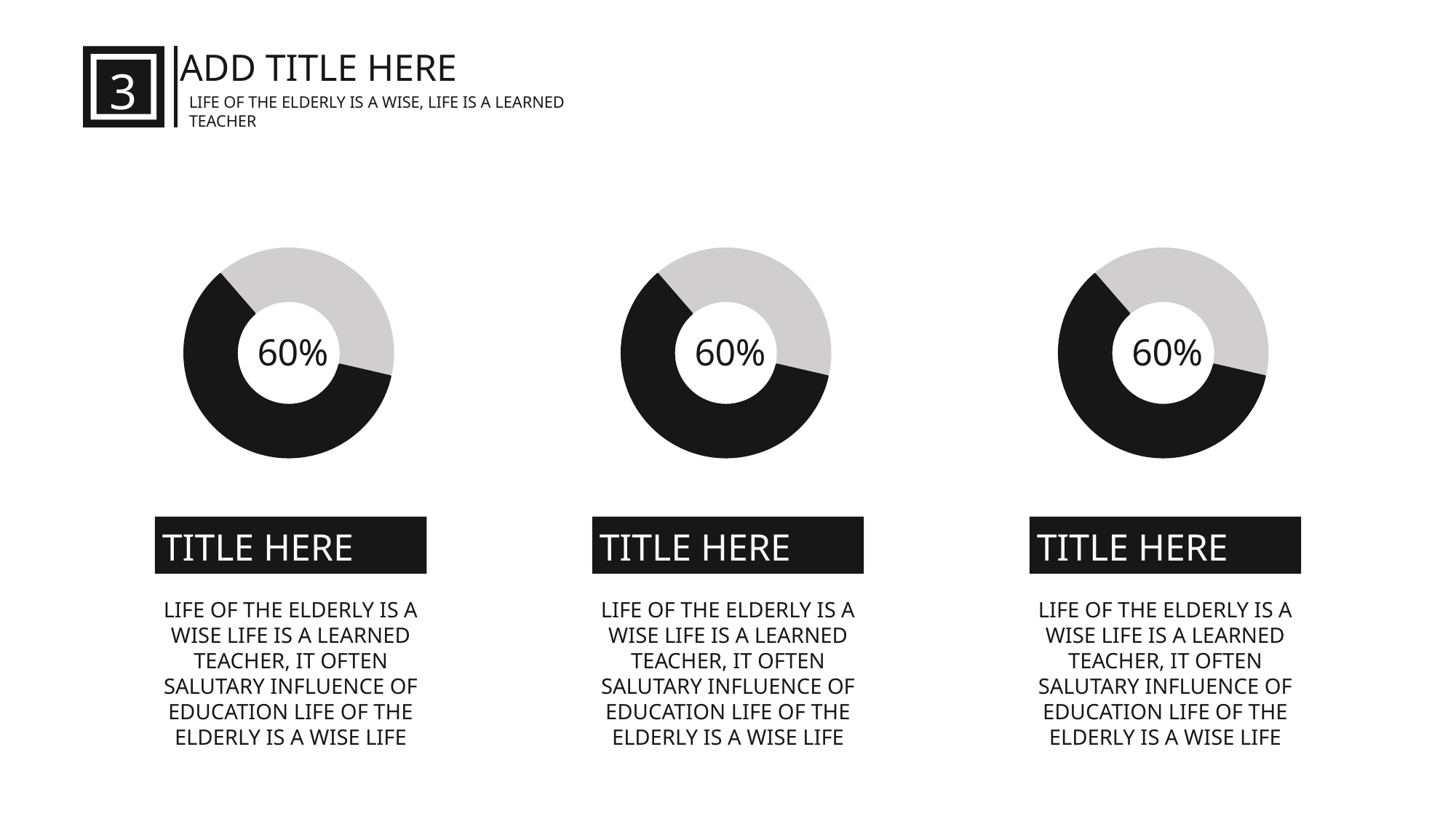
What percentage is printed in the centre of the right donut chart? 60% What kind of chart is the left chart on the slide? Donut (pie) chart How many slices does the left donut chart have? 2 In the middle donut chart, which slice is larger, the black one or the grey one? The black one What percentage is printed in the centre of the left donut chart? 60% What percentage is printed in the centre of the middle donut chart? 60% What is the title printed in the black box below the middle donut chart? TITLE HERE How many donut charts are shown on the slide? 3 Do the three donut charts all show the same percentage value? Yes, 60% What colour is the larger slice in the left donut chart? Black In the right donut chart, is the black slice's share greater or less than 50%? greater